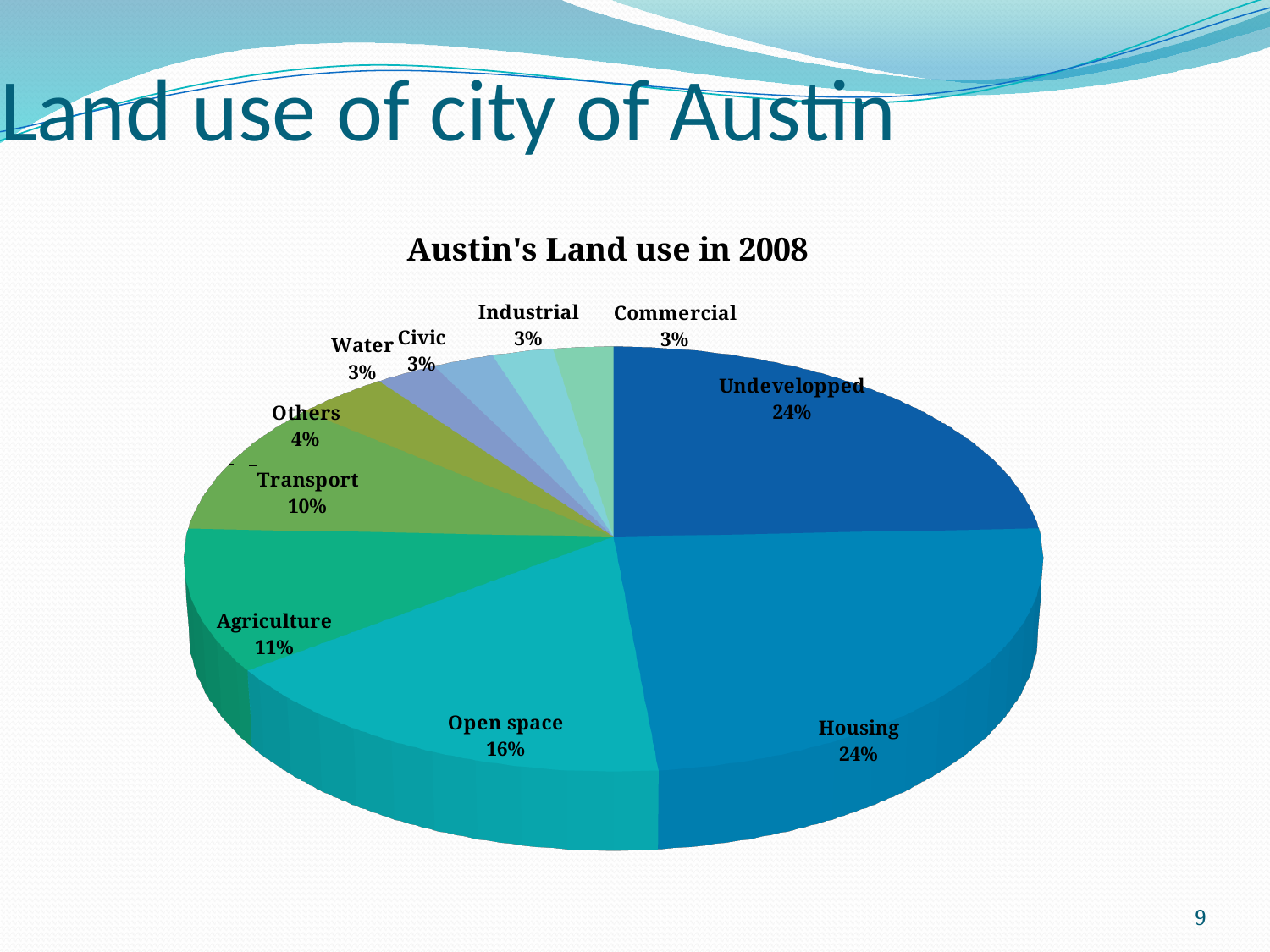
What is the difference between the Housing share and the Open space share? 8% What is the difference between the Agriculture share and the Transport share? 1% Which is larger, Open space or Agriculture? Open space How many categories does the pie chart show? 10 What percentage of land use is Agriculture? 11% What kind of chart is shown on the slide? pie chart What percentage of land use is Transport? 10% What percentage of land use is Others? 4% What is the title of the chart? Austin's Land use in 2008 What percentage of land use is Open space? 16% What share of Austin's land use in 2008 is Housing? 24% What share of the pie is Undevelopped land? 24%